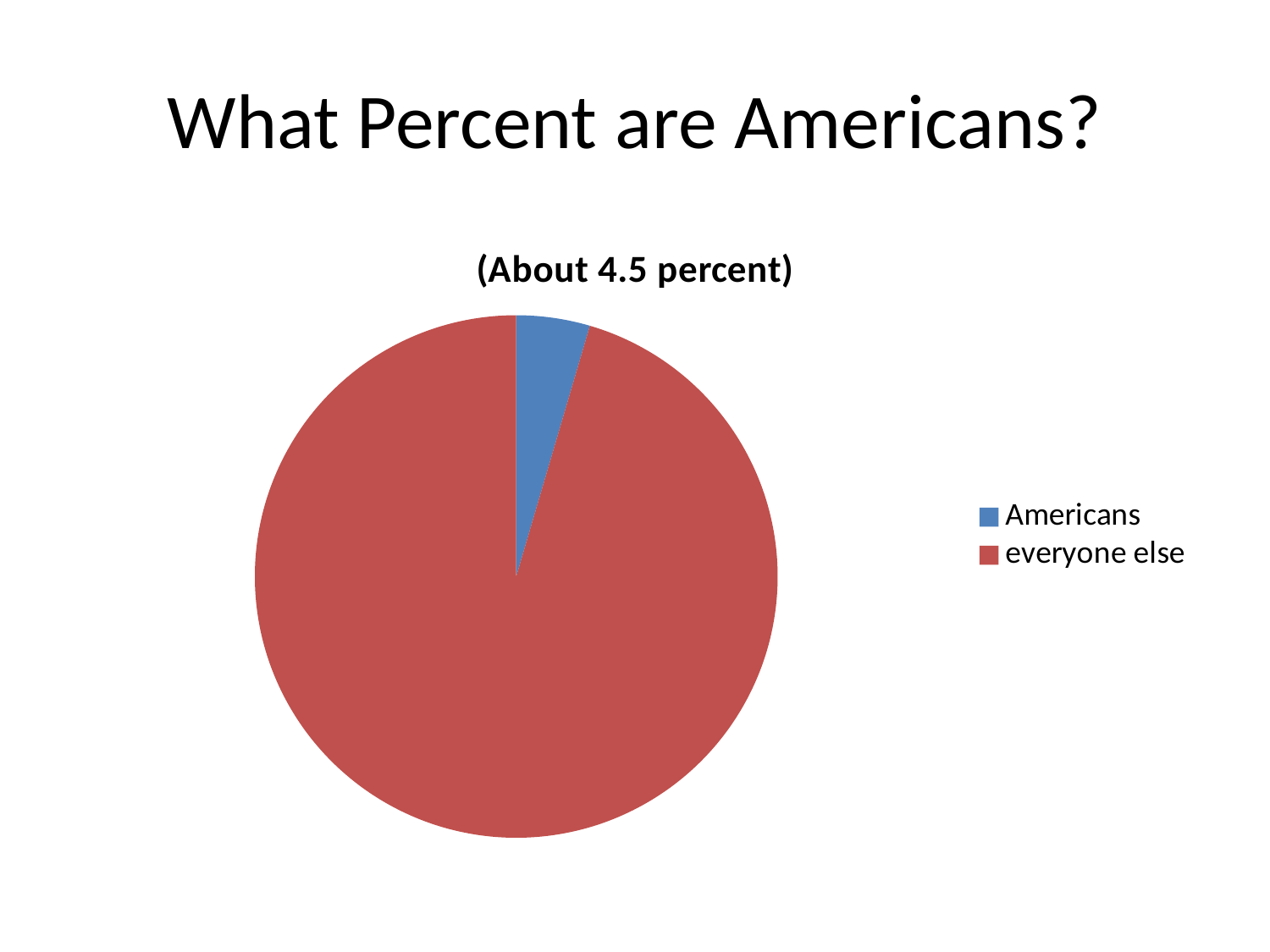
How many slices does the pie chart have? 2 What is the title printed above the pie chart? (About 4.5 percent) What colour is the Americans slice in the pie chart? blue Which slice of the pie chart is the largest? everyone else Which is larger in the pie chart, the Americans slice or the everyone else slice? everyone else Which slice of the pie chart is the smallest? Americans How many entries does the legend of the pie chart list? 2 What kind of chart is shown on the slide? pie chart